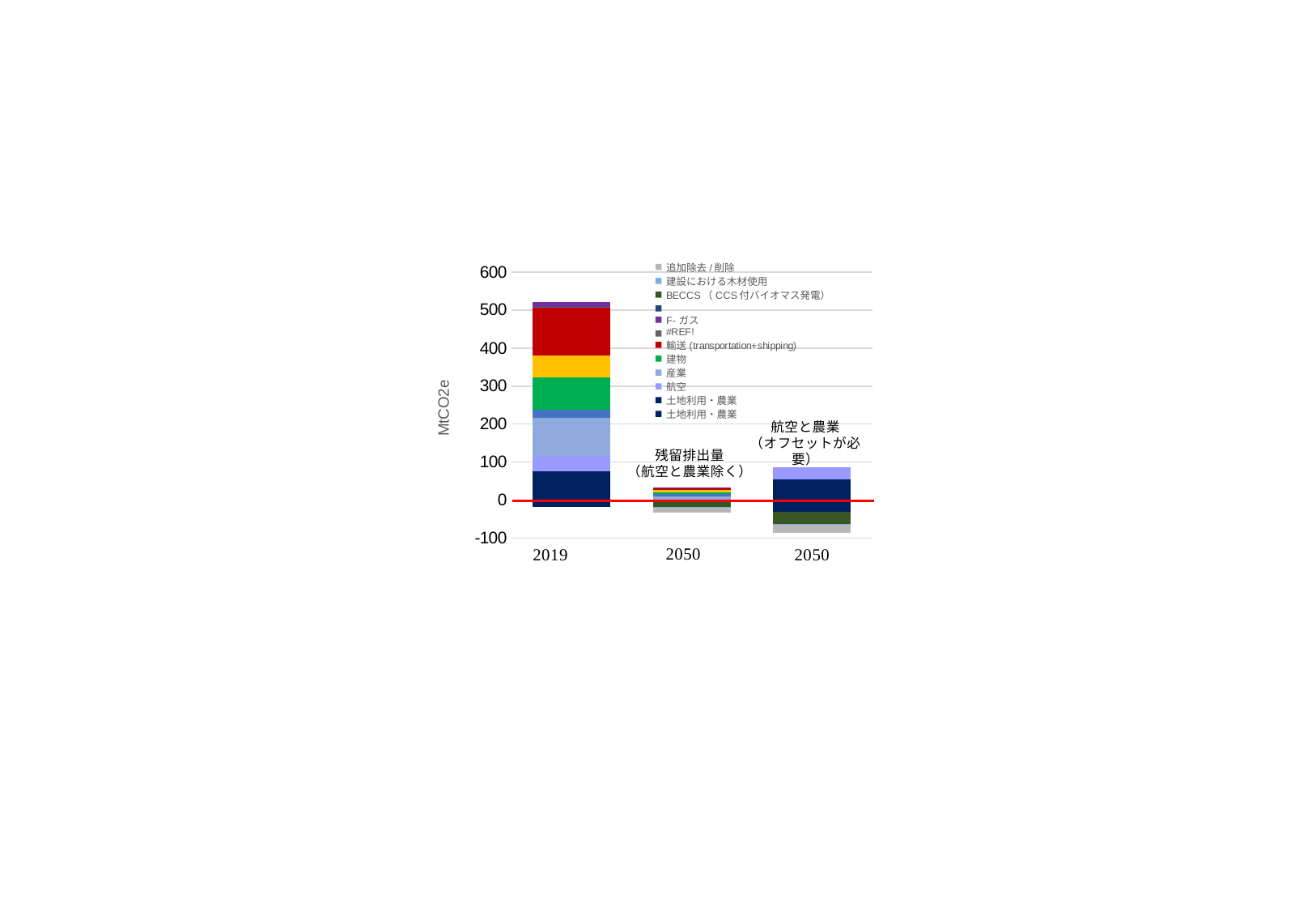
Is the top of the 2019 bar greater or less than 400? greater What colour represents 輸送 (transportation+shipping) in the legend? red How many bars are plotted in the chart? 3 What is the lowest value shown on the vertical axis? -100 Is the positive part of the middle 2050 bar (残留排出量) greater or less than 100? less Which bar reaches the highest value in the chart? 2019 Is the bottom of the right-hand 2050 bar greater or less than -50? less Do the total emissions rise or fall from the 2019 bar to the 2050 bars? fall Which is larger, the positive part of the 2019 bar or the positive part of the middle 2050 bar? 2019 What kind of chart is shown on the slide? stacked bar chart What is the label of the vertical axis? MtCO2e